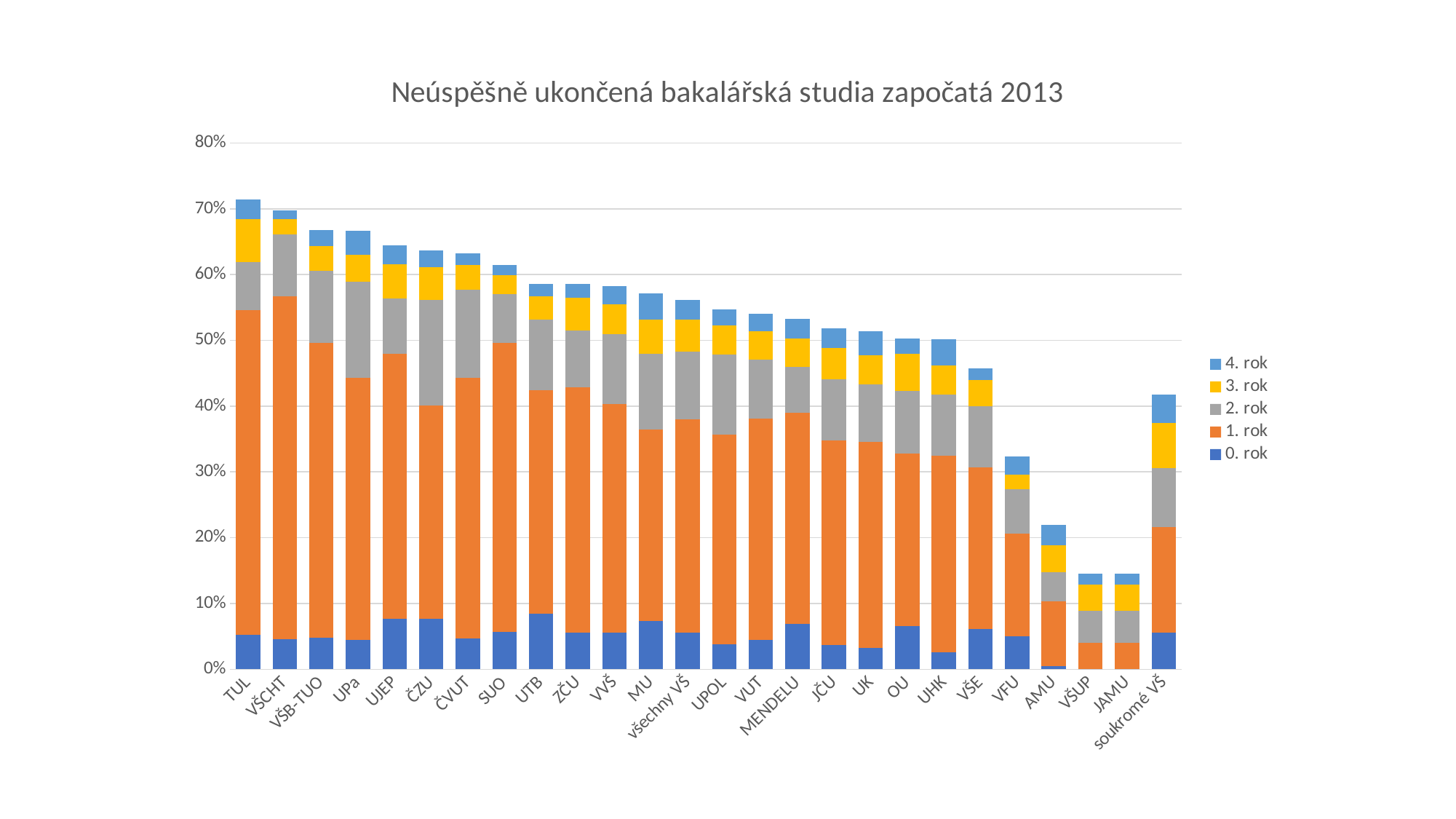
How many categories are shown on the x axis? 26 Do the total bar heights generally rise or fall along the x axis from TUL to JAMU? fall Is the total value for soukromé VŠ greater or less than 40%? greater How many series does the legend list? 5 Is the total value for TUL greater or less than 60%? greater What kind of chart is shown on the slide? stacked bar chart Is the total value for VŠE greater or less than 50%? less Which category has the highest total bar? TUL What is the title of the chart? Neúspěšně ukončená bakalářská studia započatá 2013 Which has the larger total bar, VFU or AMU? VFU Which has the larger total bar, UK or VŠE? UK